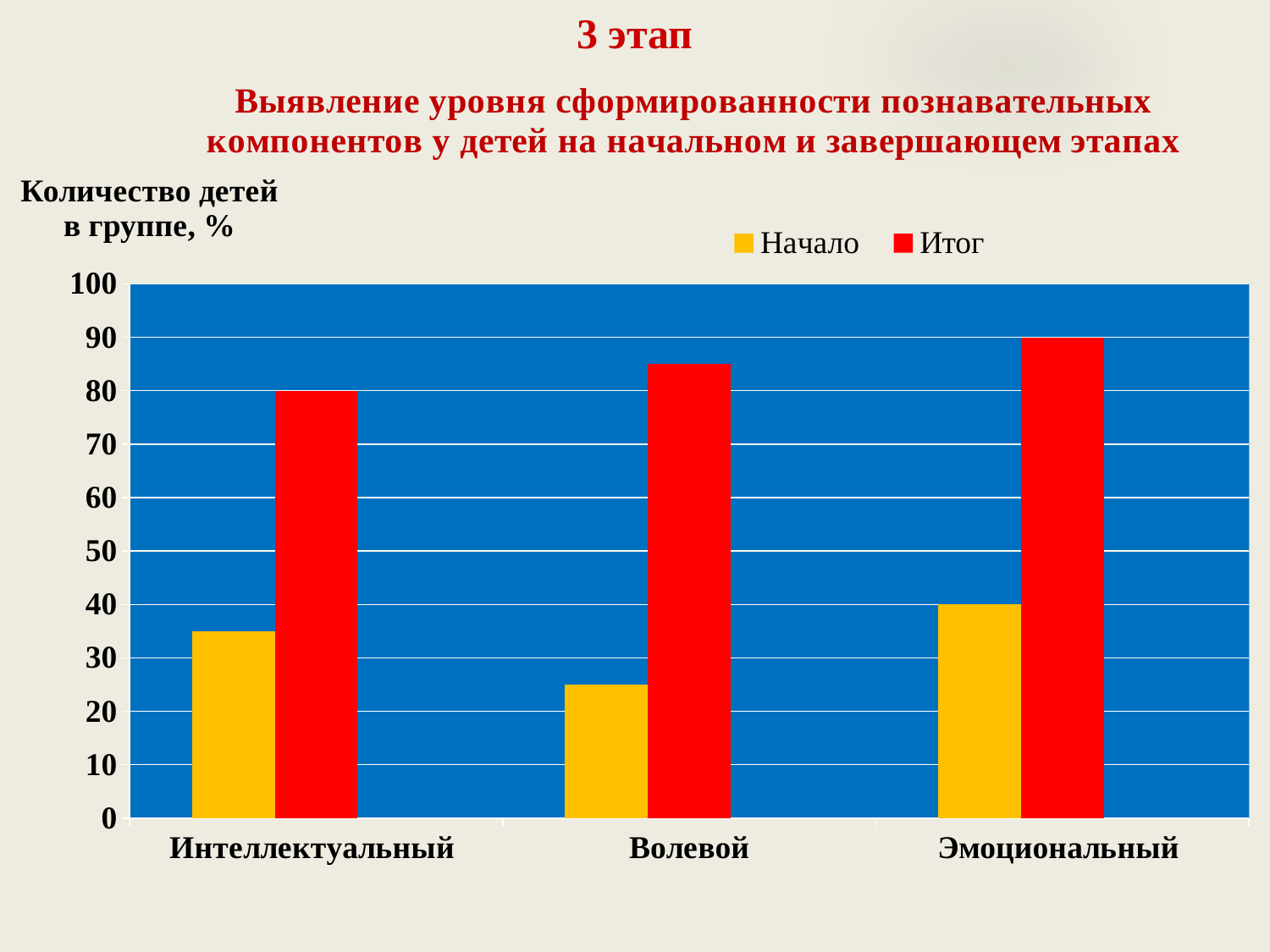
What is the value of Итог for Эмоциональный? 90 Is the value of Итог for Волевой greater or less than 80? greater Is the value of Начало for Волевой greater or less than 30? less How many categories are shown on the x axis? 3 Which category has the lowest Начало value? Волевой Which series is shown in red in the legend? Итог Which category has the highest Итог value? Эмоциональный How many series does the legend list? 2 What is the difference between the Итог values for Эмоциональный and Интеллектуальный? 10 What is the value of Начало for Эмоциональный? 40 What is the value of Итог for Интеллектуальный? 80 What kind of chart is shown on the slide? bar chart